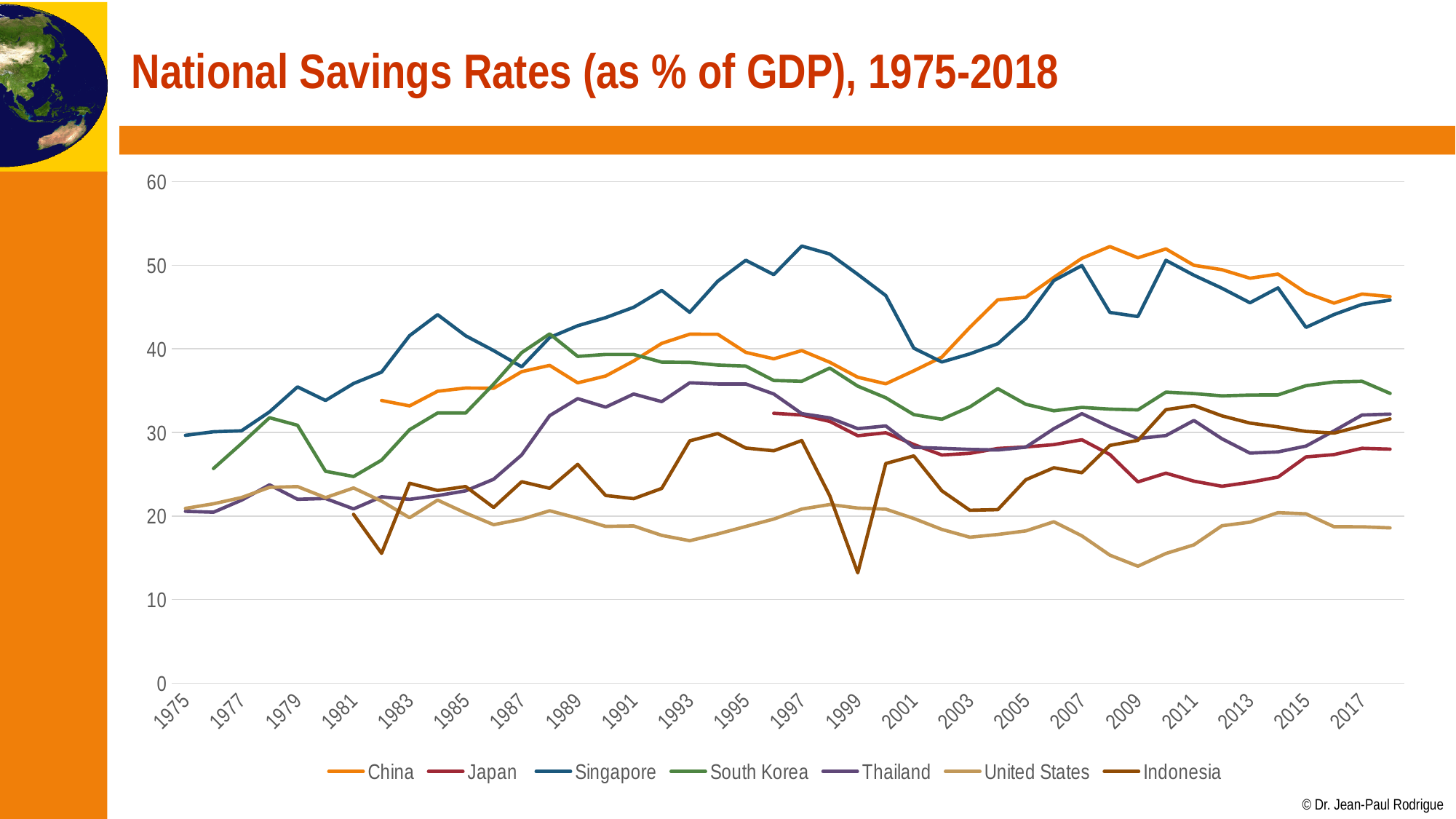
What is the title of the chart? National Savings Rates (as % of GDP), 1975-2018 Which series has the highest value in 2008? China How many series does the legend list? 7 Is the value for Thailand in 1993 greater or less than 30? greater Does the value for China rise or fall from 2001 to 2008? rise What kind of chart is shown on the slide? line chart Is the value for Singapore in 1997 greater or less than 50? greater Which series has the lowest value in 1999? Indonesia In 2017, which is larger, the value for China or the value for the United States? China Does the value for the United States rise or fall from 2006 to 2009? fall Is the value for Indonesia in 1999 greater or less than 20? less